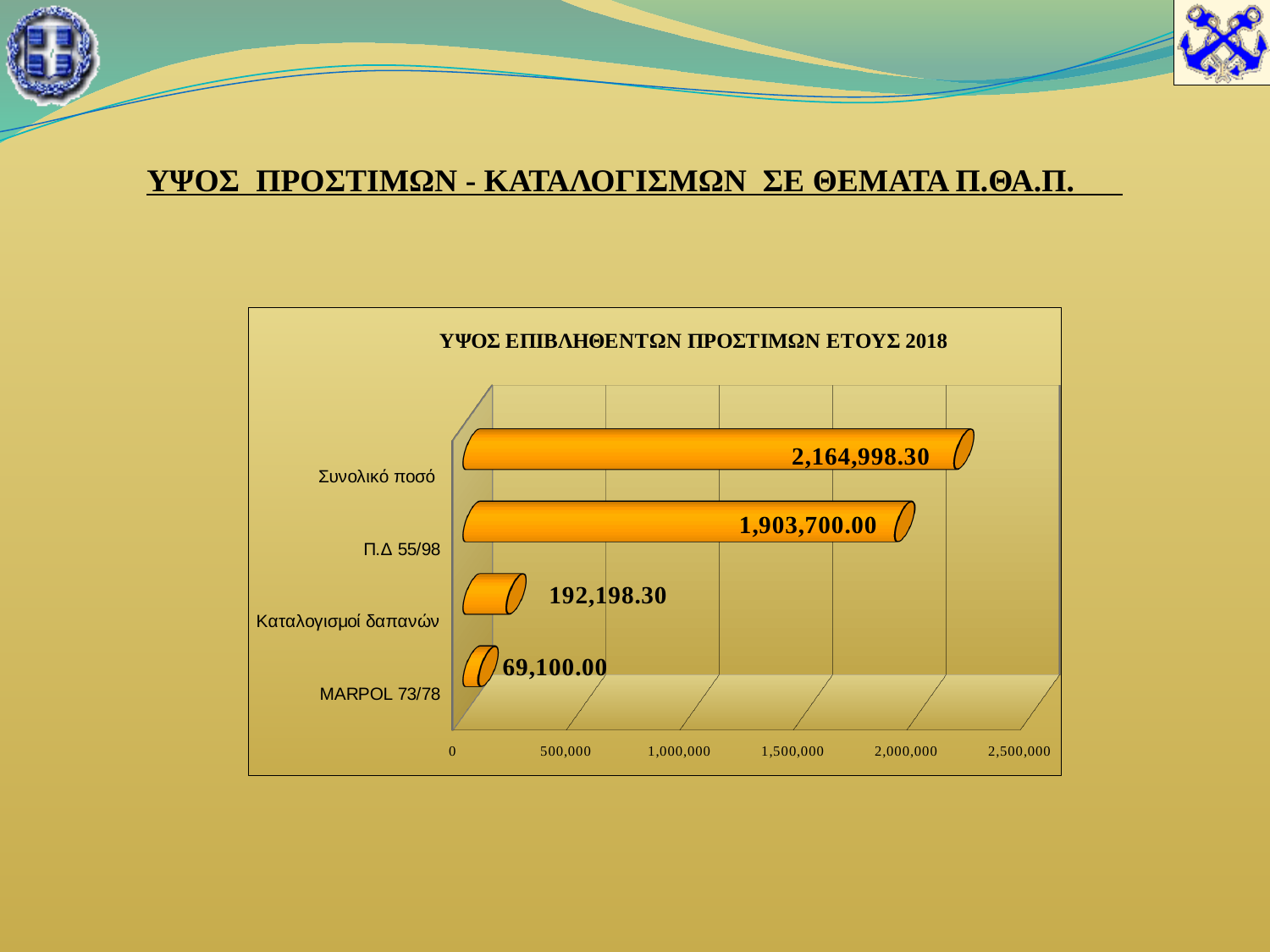
Which category has the lowest value? MARPOL 73/78 How many categories are shown in the chart? 4 What is the difference between the values for Καταλογισμοί δαπανών and MARPOL 73/78? 123,098.30 Is the value for Π.Δ 55/98 greater or less than 1,500,000? greater Which category has the highest value? Συνολικό ποσό What is the value for MARPOL 73/78? 69,100.00 What kind of chart is shown on the slide? Bar chart What is the value for Συνολικό ποσό? 2,164,998.30 What is the value for Καταλογισμοί δαπανών? 192,198.30 What is the difference between the values for Συνολικό ποσό and Π.Δ 55/98? 261,298.30 Which is larger, the value for Π.Δ 55/98 or the value for Καταλογισμοί δαπανών? Π.Δ 55/98 What is the value for Π.Δ 55/98? 1,903,700.00